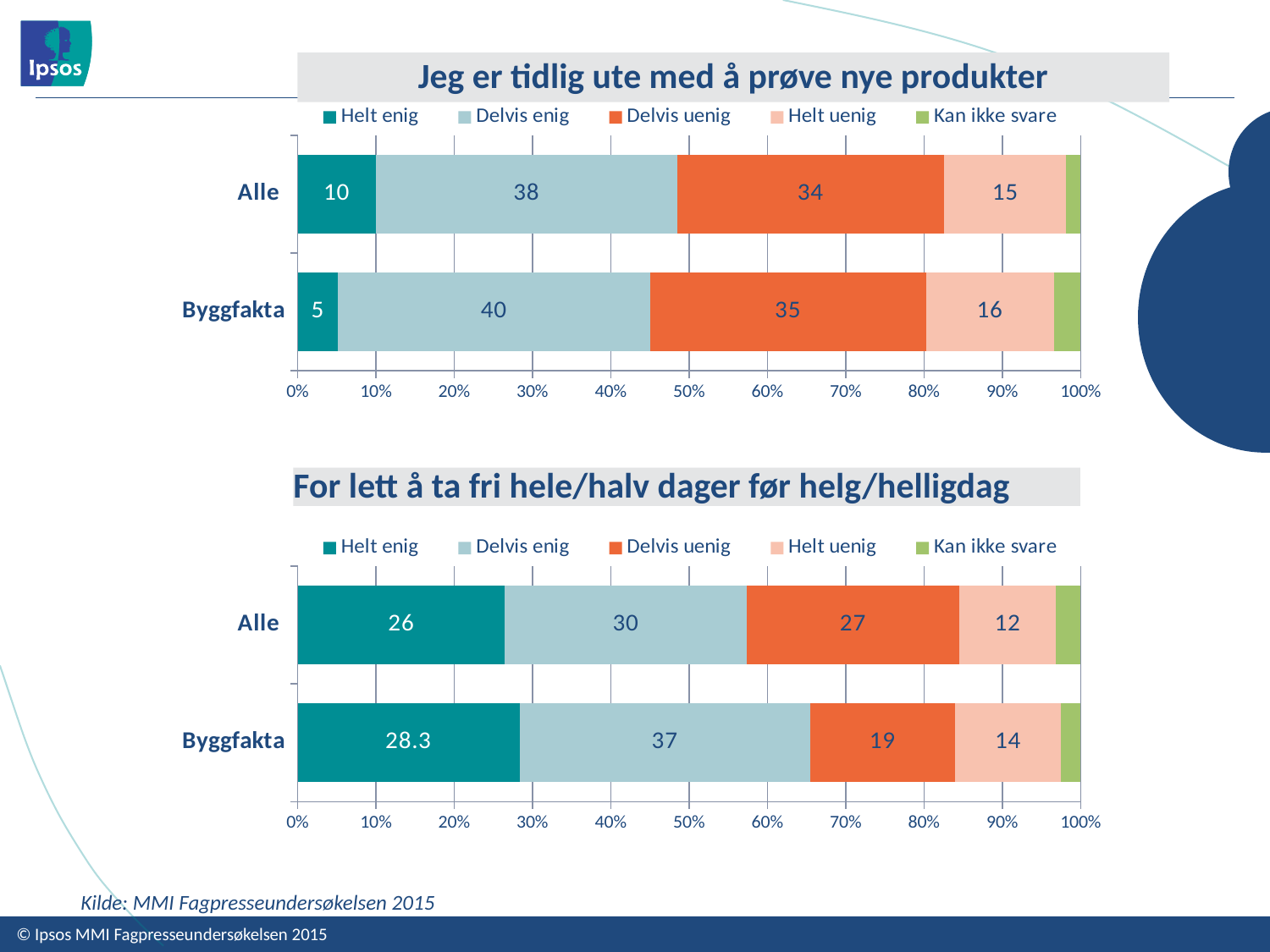
In the chart titled 'For lett å ta fri hele/halv dager før helg/helligdag', what is the 'Helt enig' value for Byggfakta? 28.3 In the chart titled 'Jeg er tidlig ute med å prøve nye produkter', what is the 'Delvis enig' value for Byggfakta? 40 In the chart titled 'Jeg er tidlig ute med å prøve nye produkter', what is the difference between the 'Helt enig' values for Alle and Byggfakta? 5 In the chart titled 'Jeg er tidlig ute med å prøve nye produkter', which category has the larger 'Delvis uenig' value, Alle or Byggfakta? Byggfakta How many categories are shown on the y axis of the chart titled 'For lett å ta fri hele/halv dager før helg/helligdag'? 2 In the chart titled 'For lett å ta fri hele/halv dager før helg/helligdag', which category has the larger 'Delvis uenig' value, Alle or Byggfakta? Alle In the chart titled 'For lett å ta fri hele/halv dager før helg/helligdag', what is the difference between the 'Delvis enig' values for Byggfakta and Alle? 7 In the chart titled 'For lett å ta fri hele/halv dager før helg/helligdag', what is the 'Delvis uenig' value for Alle? 27 In the chart titled 'Jeg er tidlig ute med å prøve nye produkter', what is the 'Helt enig' value for Alle? 10 In the chart titled 'Jeg er tidlig ute med å prøve nye produkter', what is the 'Helt uenig' value for Byggfakta? 16 How many series does the legend list in the chart titled 'For lett å ta fri hele/halv dager før helg/helligdag'? 5 What kind of chart is the chart titled 'Jeg er tidlig ute med å prøve nye produkter'? Stacked bar chart